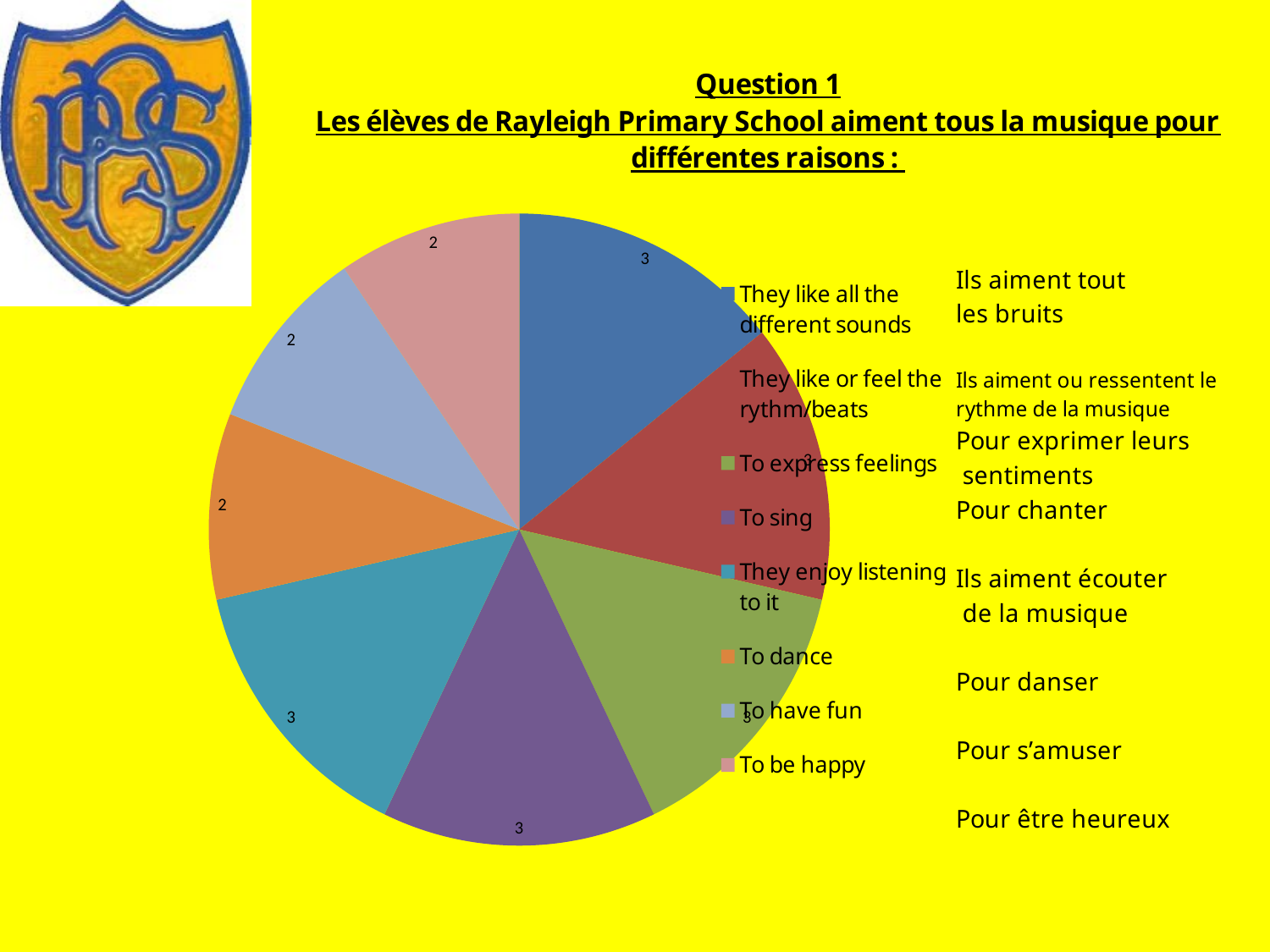
How many entries does the legend of the pie chart list? 8 How many slices does the pie chart have? 8 What is the value for "To dance" in the pie chart? 2 Which is larger in the pie chart, "To sing" or "To dance"? To sing Which legend entry of the pie chart is shown in orange? To dance What is the value for "To sing" in the pie chart? 3 What is the value for "To be happy" in the pie chart? 2 What is the difference between the values for "They enjoy listening to it" and "To be happy" in the pie chart? 1 What is the value for "To have fun" in the pie chart? 2 What kind of chart is shown on the slide? pie chart What is the value for "They enjoy listening to it" in the pie chart? 3 What is the value for "They like all the different sounds" in the pie chart? 3